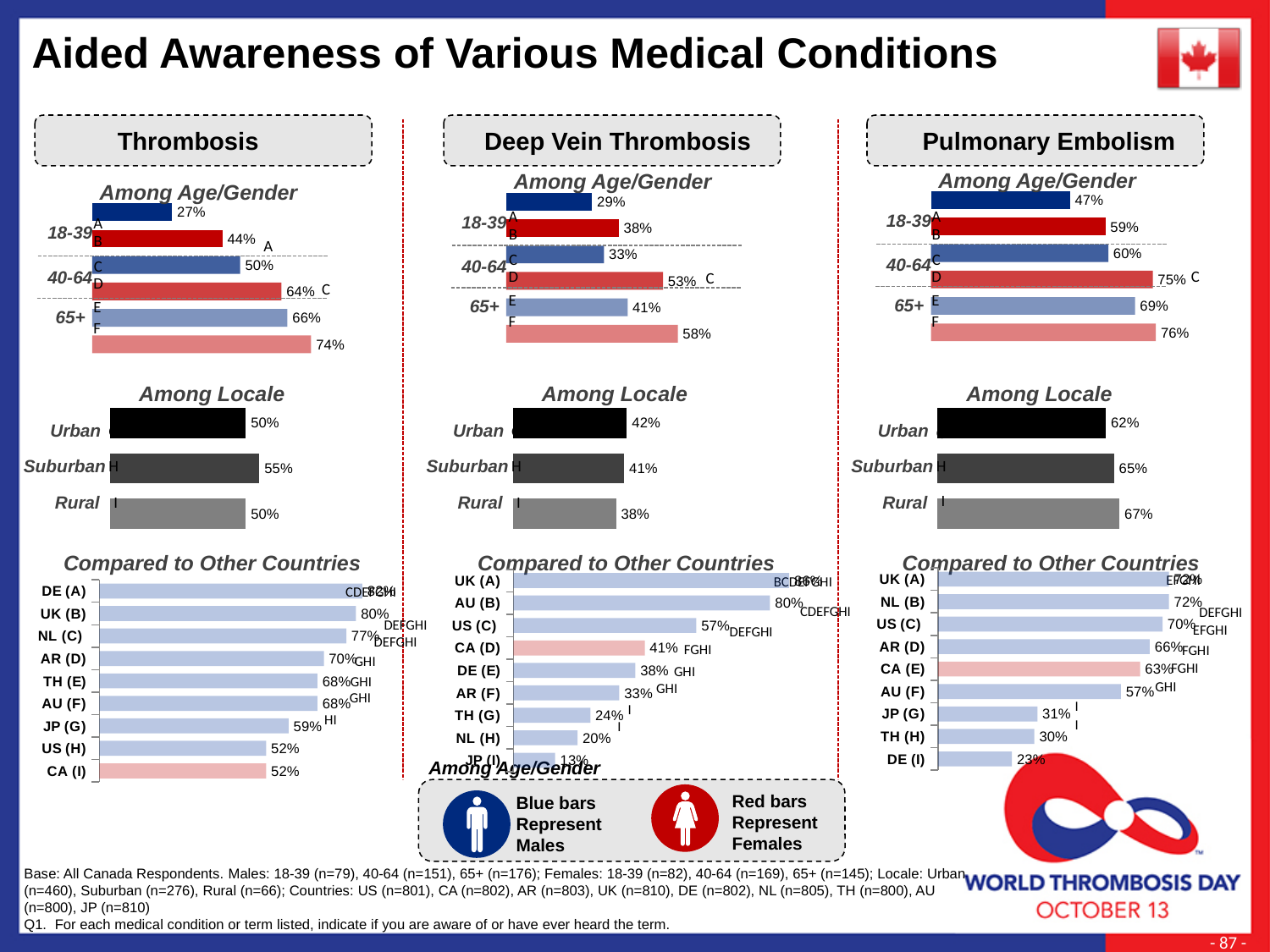
According to the legend at the bottom of the slide, what do the red bars represent in the 'Among Age/Gender' charts? Females In the Deep Vein Thrombosis 'Among Age/Gender' chart, what is the difference between the female bar (D) and the male bar (C) for the 40-64 group? 20% In the Deep Vein Thrombosis 'Among Locale' chart, which locale has the lowest value? Rural What type of chart is used in the 'Among Locale' sections on this slide? Bar chart In the Deep Vein Thrombosis 'Compared to Other Countries' chart, what is the value for JP (I)? 13% In the Thrombosis 'Among Age/Gender' chart, what is the value for the female (red) bar in the 65+ group (bar F)? 74% In the Thrombosis 'Compared to Other Countries' chart, how many countries are listed? 9 In the Thrombosis 'Among Locale' chart, what is the value for Suburban? 55% In the Deep Vein Thrombosis 'Compared to Other Countries' chart, what is the value for US (C)? 57% In the Pulmonary Embolism 'Compared to Other Countries' chart, what is the value for CA (E)? 63% In the Pulmonary Embolism 'Among Age/Gender' chart, which is larger: the male bar (C) or the female bar (D) for the 40-64 group? D (75%) In the Pulmonary Embolism 'Among Locale' chart, what is the difference between Rural and Urban? 5%